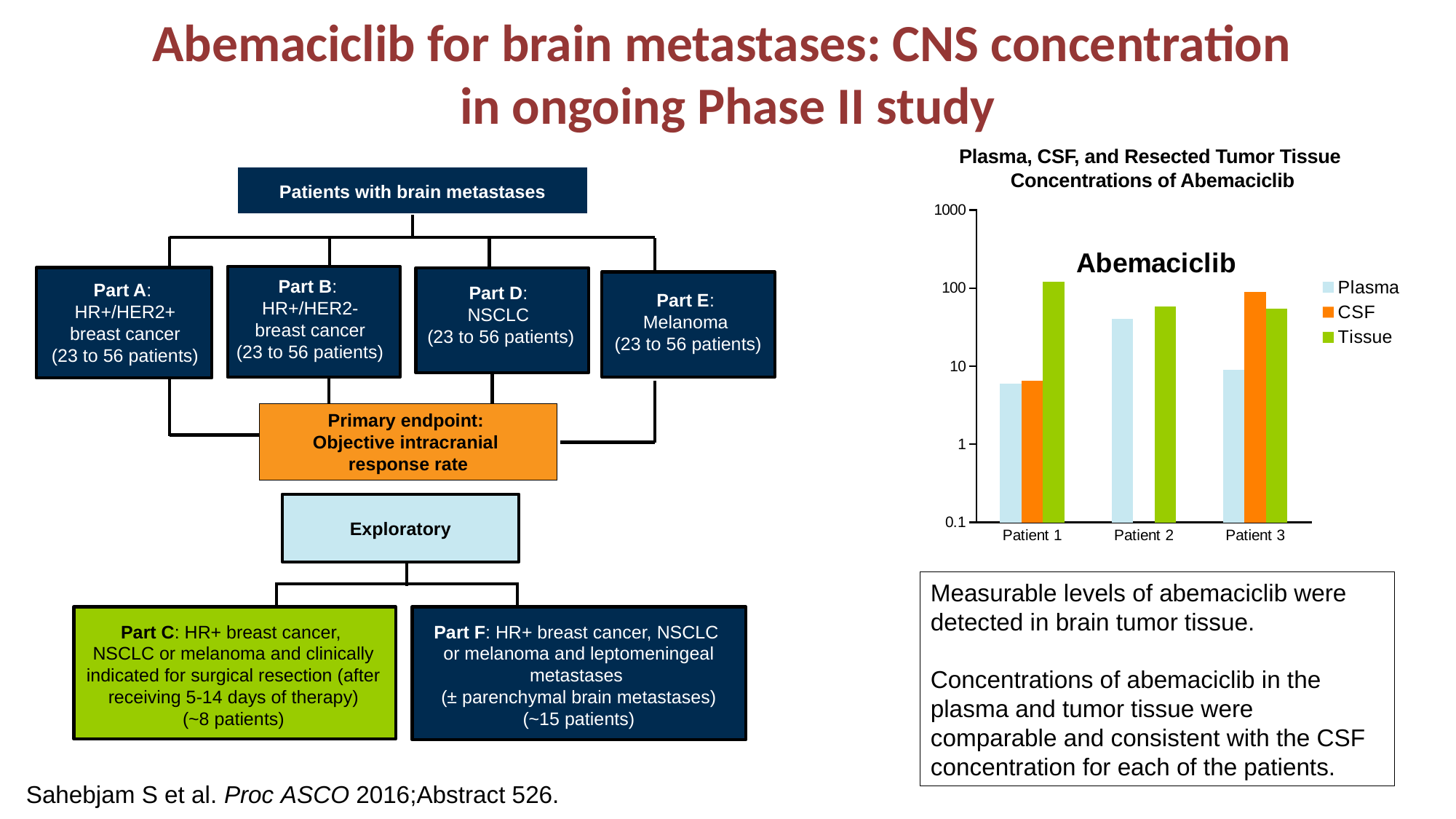
Is the Tissue concentration for Patient 1 greater or less than 100? greater What kind of chart is shown on the right side of the slide? Bar chart Is the Plasma concentration for Patient 2 greater or less than 10? greater Which patient has the highest Tissue concentration? Patient 1 Which patient has no CSF bar shown in the chart? Patient 2 For Patient 2, which is larger: the Plasma or the Tissue concentration? Tissue Which series has the highest concentration for Patient 3? CSF Which patient has the highest Plasma concentration? Patient 2 Is the Plasma concentration for Patient 1 greater or less than 10? less How many series does the legend of the abemaciclib concentration chart list? 3 How many patients are shown on the x axis of the concentration chart? 3